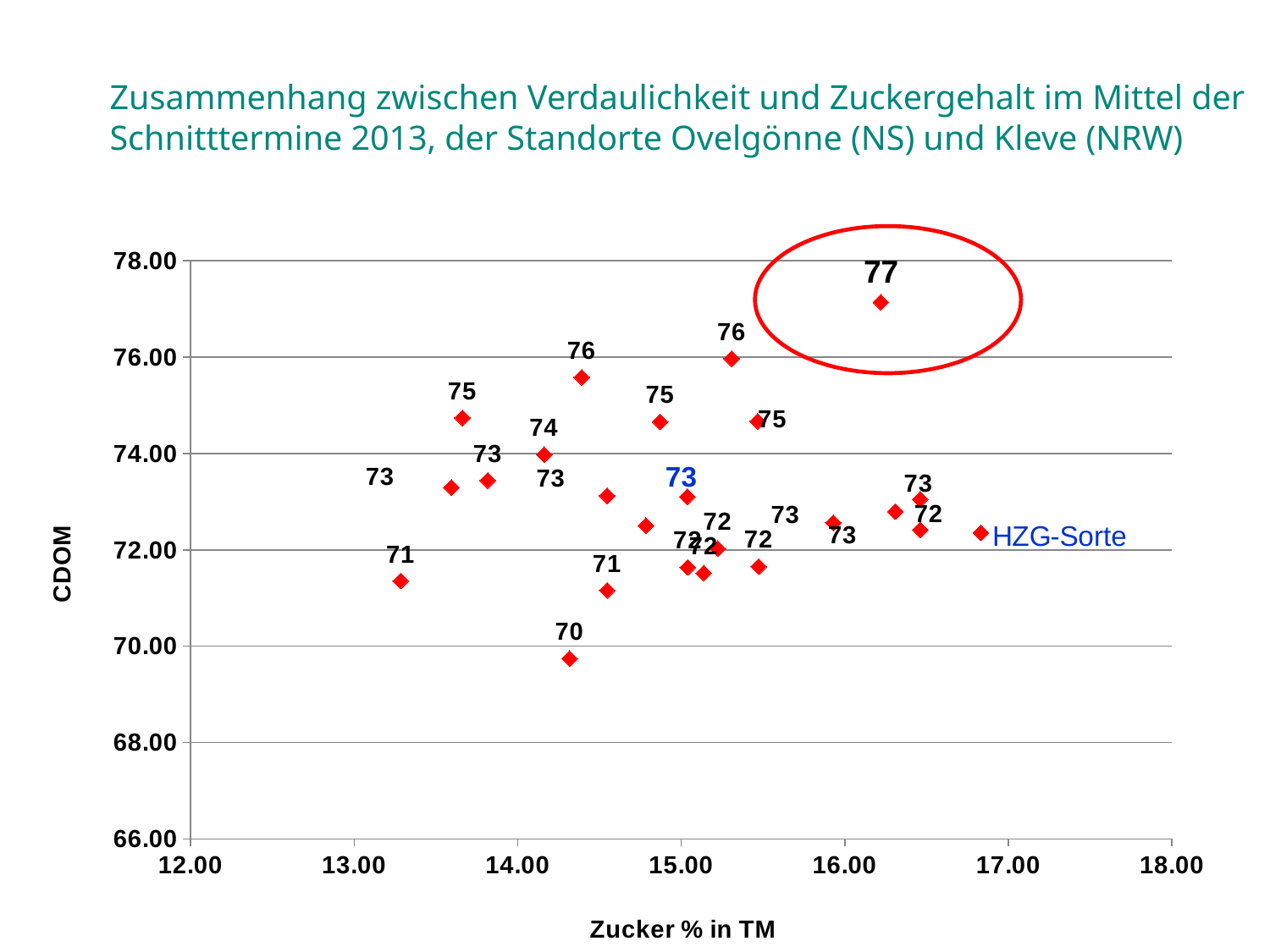
Is the CDOM value of the point labelled 70 greater or less than 70.00? less Is the CDOM value of the point labelled HZG-Sorte greater or less than 74.00? less Which labelled point is enclosed by the red ellipse? 77 Is the Zucker % in TM value of the point labelled HZG-Sorte greater or less than 16.00? greater Which has the higher CDOM value: the point circled in red or the point labelled 76 at about 15.3 Zucker % in TM? the point circled in red What is the difference between the highest labelled point value (77) and the lowest labelled point value (70)? 7 What is the highest CDOM value labelled on any point in the chart? 77 What kind of chart is shown on the slide? scatter chart What is the title of the x axis? Zucker % in TM What is the lowest CDOM value labelled on any point in the chart? 70